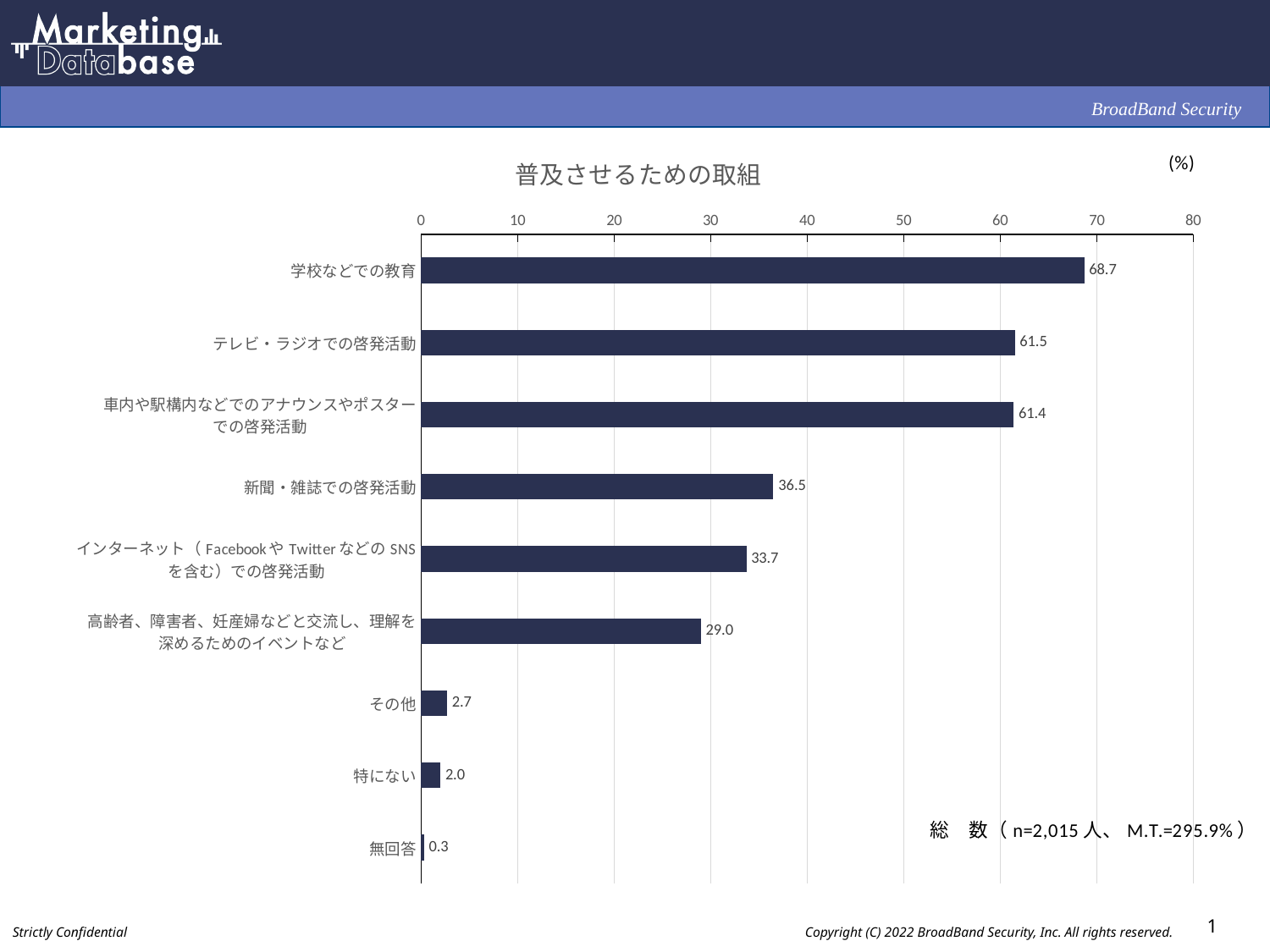
Which is larger, the value for 新聞・雑誌での啓発活動 or the value for インターネット（FacebookやTwitterなどのSNSを含む）での啓発活動? 新聞・雑誌での啓発活動 What is the value for 新聞・雑誌での啓発活動? 36.5 What is the value for 学校などでの教育? 68.7 Which category has the lowest value? 無回答 What is the title of the chart? 普及させるための取組 What is the value for 無回答? 0.3 How many categories are shown in the chart? 9 What kind of chart is shown on the slide? bar chart What is the value for 特にない? 2.0 Is the value for 高齢者、障害者、妊産婦などと交流し、理解を深めるためのイベントなど greater or less than 30? less Which category has the highest value? 学校などでの教育 What is the difference between the values for 学校などでの教育 and テレビ・ラジオでの啓発活動? 7.2